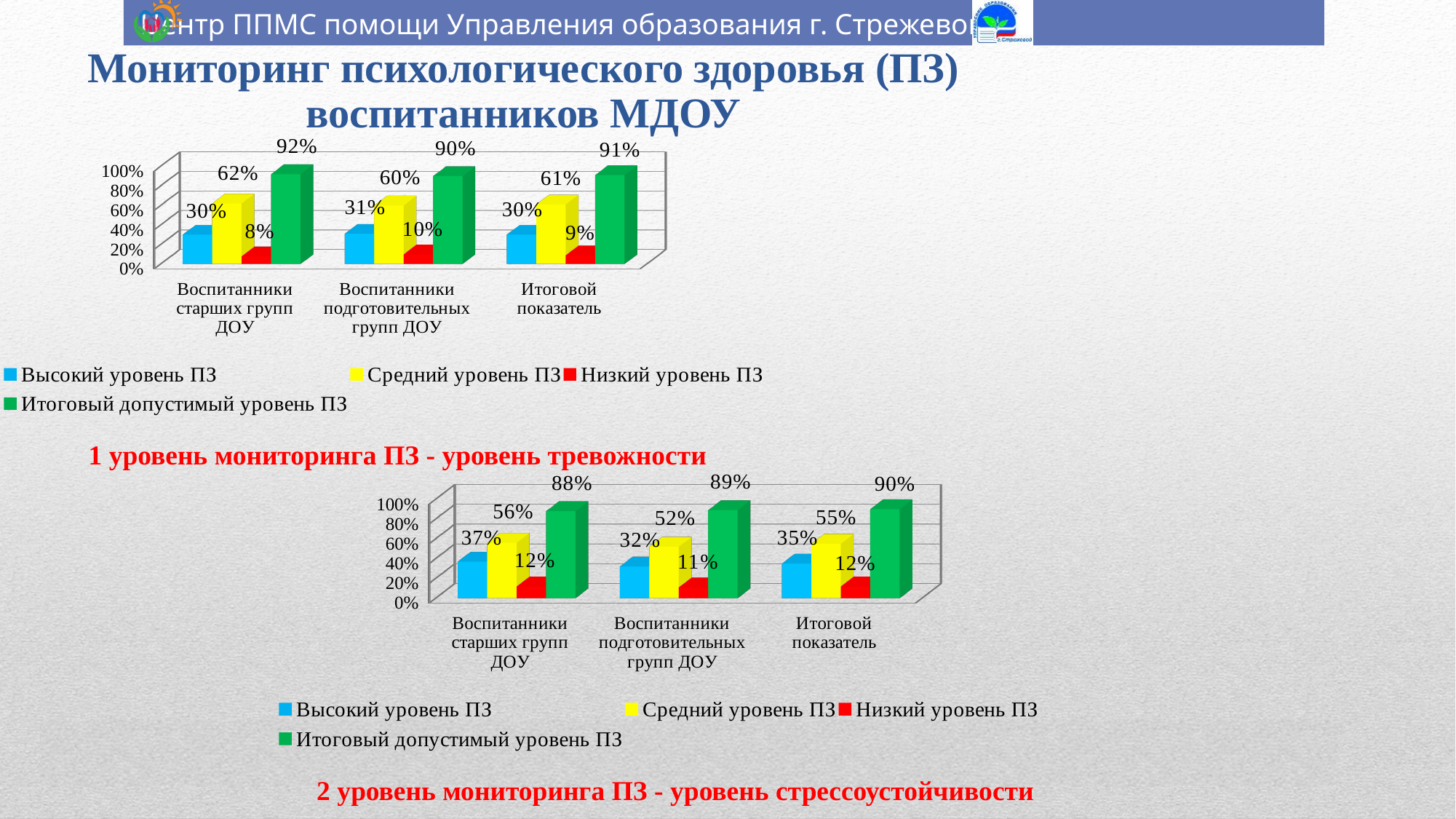
In the bottom chart (уровень стрессоустойчивости), what is the value of Высокий уровень ПЗ for Воспитанники старших групп ДОУ? 37% In the bottom chart (уровень стрессоустойчивости), which category has the highest Итоговый допустимый уровень ПЗ? Итоговой показатель In the top chart (уровень тревожности), what is the Итоговый допустимый уровень ПЗ for Итоговой показатель? 91% How many series does the legend of the top chart (уровень тревожности) list? 4 In the top chart (уровень тревожности), which is larger: Высокий уровень ПЗ for Воспитанники старших групп ДОУ or for Воспитанники подготовительных групп ДОУ? Воспитанники подготовительных групп ДОУ In the top chart (уровень тревожности), what is the value of Средний уровень ПЗ for Воспитанники старших групп ДОУ? 62% In the bottom chart (уровень стрессоустойчивости), what is the value of Средний уровень ПЗ for Итоговой показатель? 55% What type of chart is the top chart (уровень тревожности)? Bar chart How many categories are shown on the x axis of the bottom chart (уровень стрессоустойчивости)? 3 In the bottom chart (уровень стрессоустойчивости), what is the difference between Средний уровень ПЗ for Воспитанники старших групп ДОУ and for Воспитанники подготовительных групп ДОУ? 4% In the top chart (уровень тревожности), which category has the lowest Низкий уровень ПЗ? Воспитанники старших групп ДОУ In the top chart (уровень тревожности), what is the value of Низкий уровень ПЗ for Воспитанники подготовительных групп ДОУ? 10%